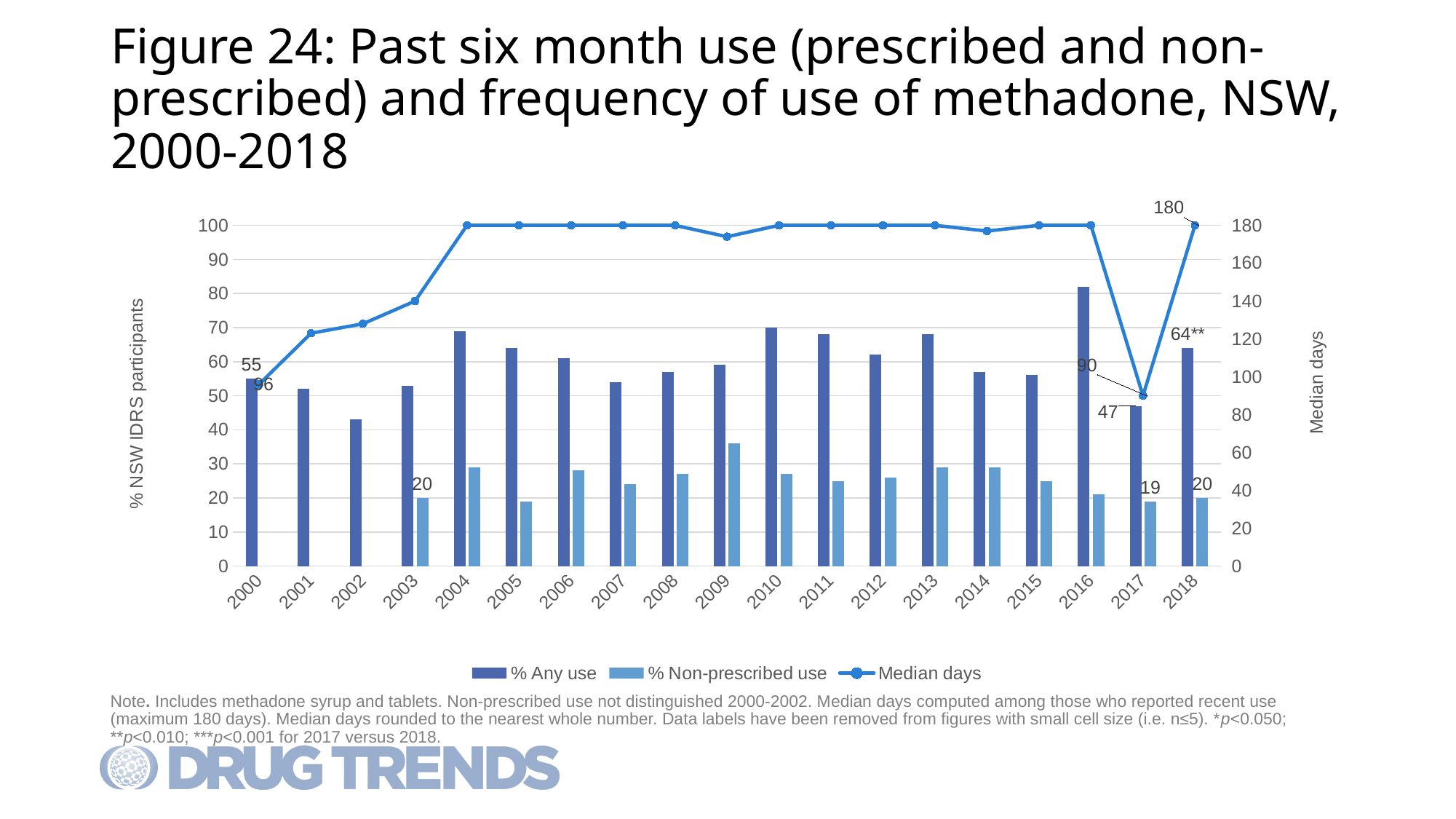
How many series does the legend list? 3 What is the % Any use value for 2000? 55 Which year has the higher % Any use, 2016 or 2017? 2016 What is the Median days value for 2000? 96 By how many percentage points did % Any use change from 2017 to 2018? 17 What is the % Any use value for 2017? 47 What is the Median days value for 2018? 180 Which year has the highest % Any use? 2016 How many years are shown on the x axis? 19 What is the % Non-prescribed use value for 2003? 20 What is the % Non-prescribed use value for 2018? 20 Is the % Non-prescribed use value for 2009 greater or less than 30? greater